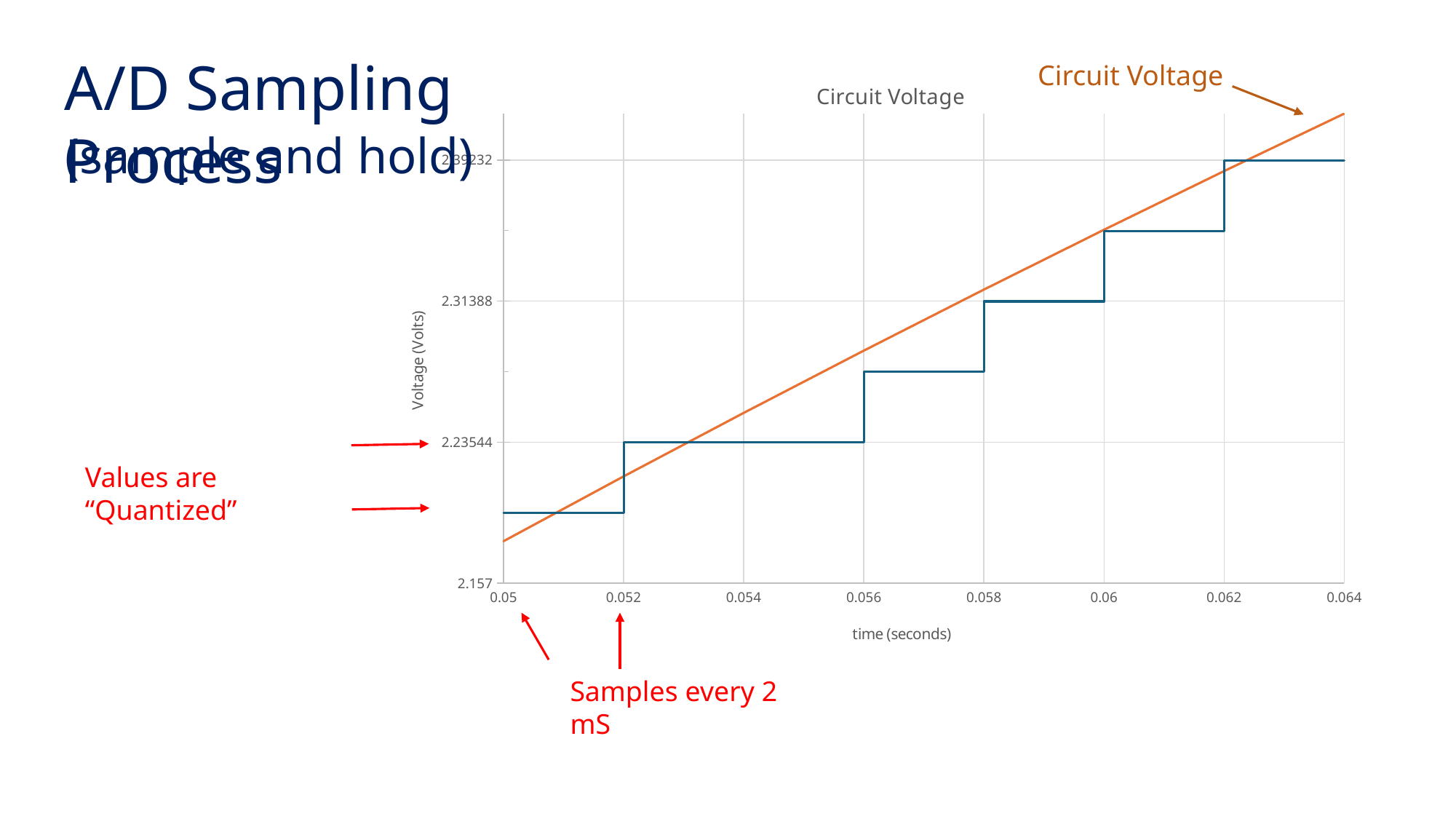
What is the lowest value shown on the y axis? 2.157 What voltage does the blue stepped line hold between 0.062 and 0.064 seconds? 2.39232 At 0.055 seconds, is the orange Circuit Voltage line above or below the blue stepped line? above Is the orange Circuit Voltage line at 0.064 seconds greater or less than 2.39232? greater What is the label of the x axis of the chart? time (seconds) Does the orange Circuit Voltage line rise or fall as time increases? rises What kind of chart is shown on the slide? line chart What is the title of the chart? Circuit Voltage What is the highest time value shown on the x axis? 0.064 What voltage does the blue stepped line hold between 0.052 and 0.056 seconds? 2.23544 Is the blue stepped line at 0.05 seconds greater or less than 2.23544? less What voltage does the blue stepped line hold between 0.058 and 0.06 seconds? 2.31388